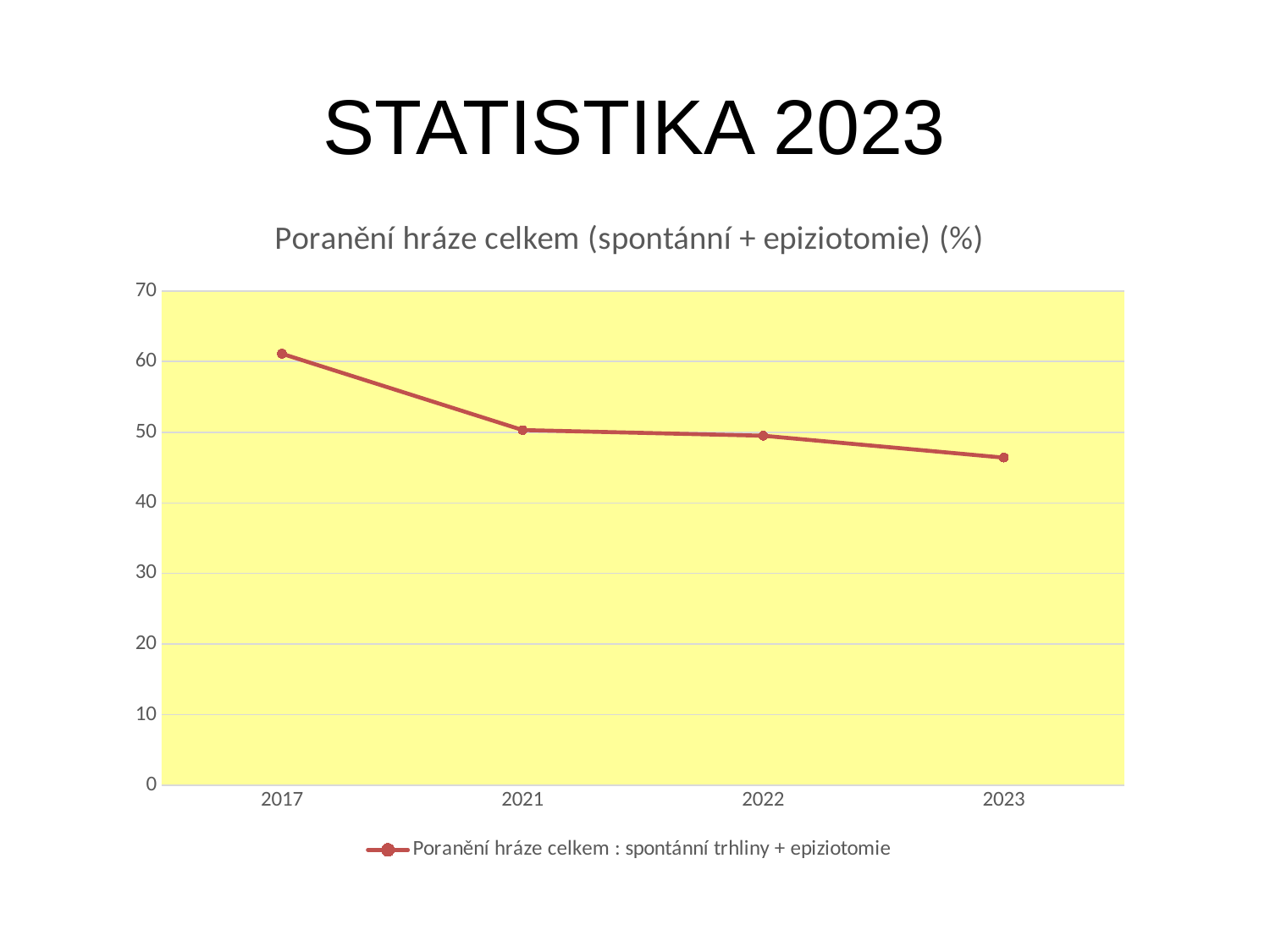
Is the value for 2017 greater or less than 50? greater Do the values rise or fall from 2017 to 2023? fall What is the title of the chart? Poranění hráze celkem (spontánní + epiziotomie) (%) Which year has the lowest value? 2023 Which year has the highest value? 2017 Which is larger, the value for 2017 or the value for 2023? 2017 How many data points are plotted on the line? 4 Is the value for 2023 greater or less than 50? less How many series does the legend list? 1 Is the value for 2023 greater or less than 40? greater What kind of chart is shown on the slide? line chart What is the legend entry for the plotted series? Poranění hráze celkem : spontánní trhliny + epiziotomie